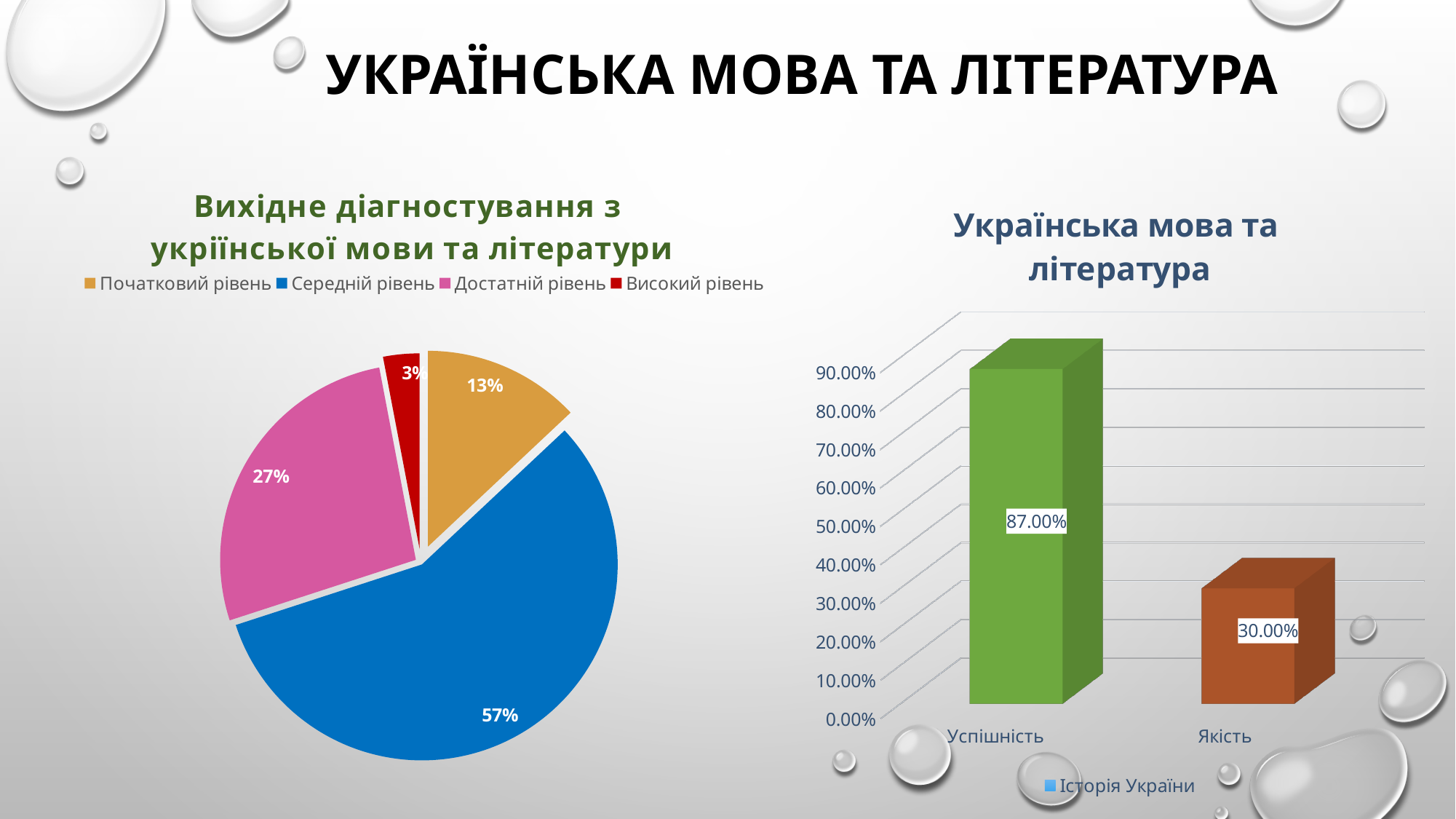
In the pie chart on the left, which level has the largest slice? Середній рівень What kind of chart is the chart on the left? Pie chart What series name does the legend of the bar chart on the right list? Історія України In the pie chart on the left, what is the difference between the Достатній рівень and Початковий рівень shares? 14% In the bar chart on the right, what is the value for Успішність? 87.00% What kind of chart is the chart on the right? Bar chart In the pie chart on the left, what share does the Середній рівень slice have? 57% In the pie chart on the left, how many slices are there? 4 In the pie chart on the left, which level has the smallest slice? Високий рівень In the bar chart on the right, what is the difference between Успішність and Якість? 57.00% In the bar chart on the right, what is the value for Якість? 30.00% In the pie chart on the left, what share does the Високий рівень slice have? 3%